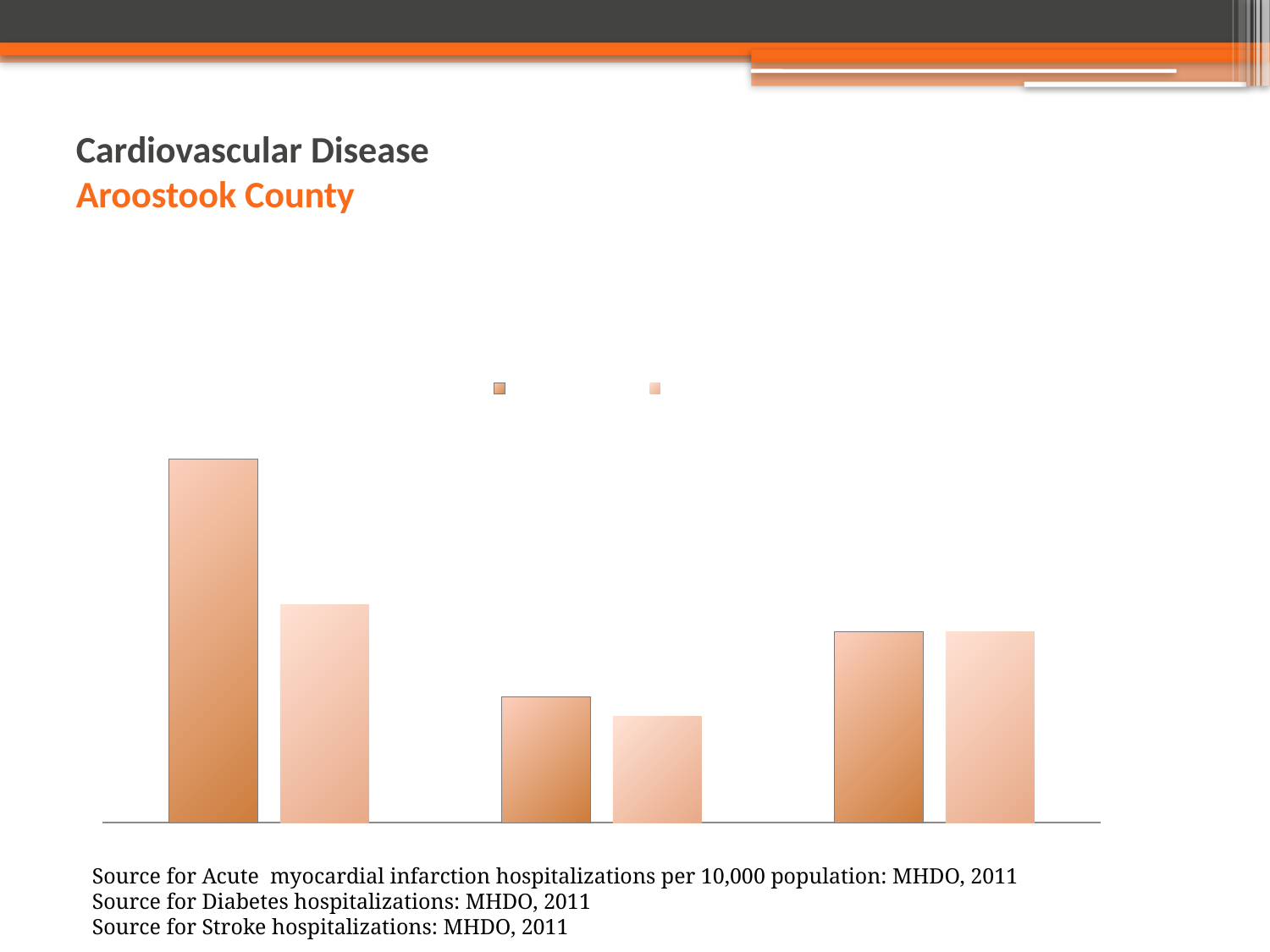
In the leftmost group of bars, is the darker orange bar or the lighter orange bar taller? the darker orange bar What colours are used for the two series in the chart? darker orange and lighter orange How many series does the legend of the chart list? 2 Which group of bars, counting from the left, contains the tallest bar in the chart? the first (leftmost) group How many groups of bars are plotted in the chart? 3 Which group of bars, counting from the left, contains the shortest bar in the chart? the second (middle) group What kind of chart is shown on the slide? bar chart How many bars are plotted in total in the chart? 6 In the middle group of bars, is the darker orange bar or the lighter orange bar taller? the darker orange bar